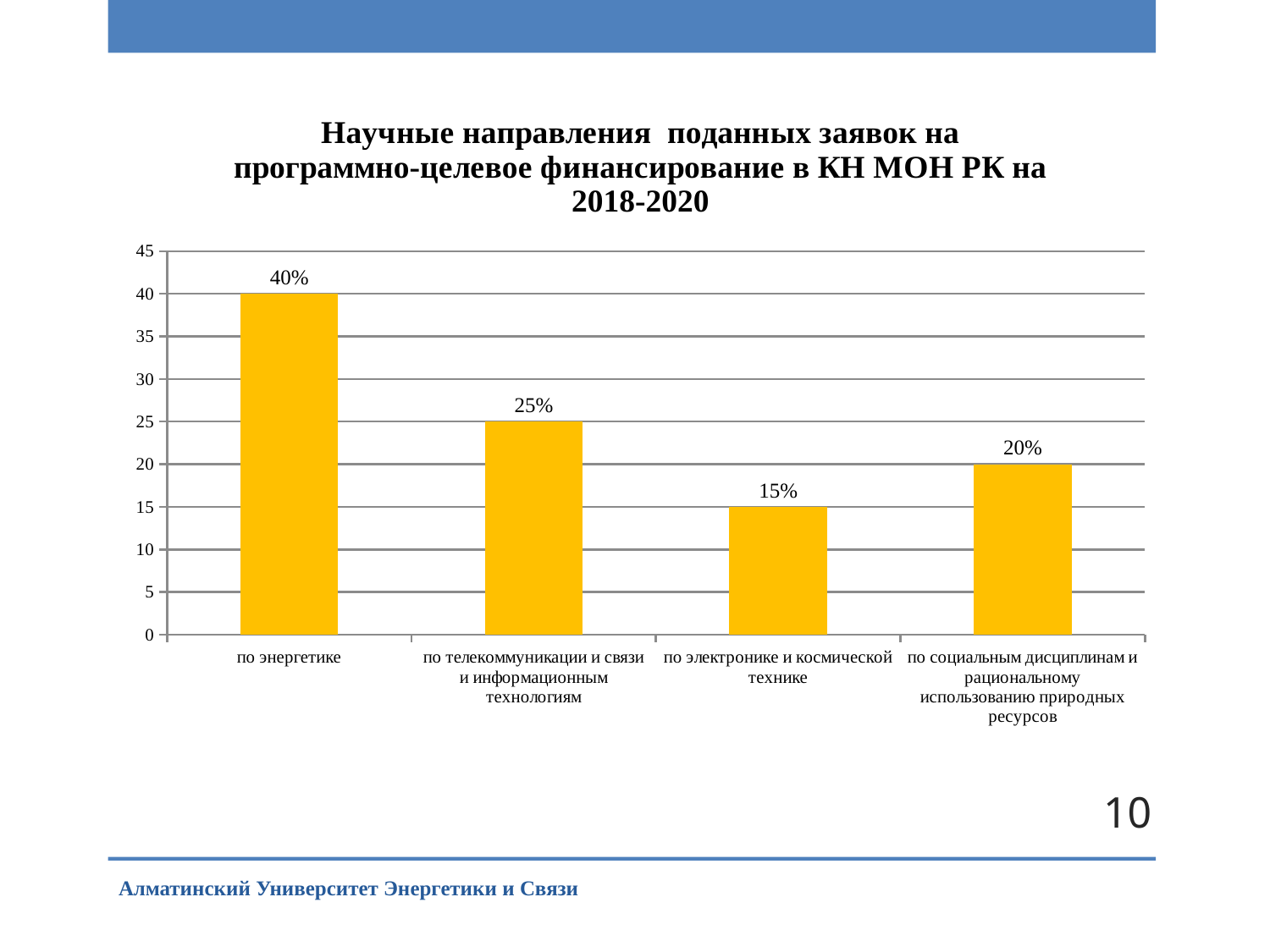
What is the value for "по электронике и космической технике"? 15% What is the difference between the values for "по энергетике" and "по телекоммуникации и связи и информационным технологиям"? 15% What is the value for "по энергетике"? 40% Is the value for "по телекоммуникации и связи и информационным технологиям" greater or less than 30? less What is the value for "по социальным дисциплинам и рациональному использованию природных ресурсов"? 20% Which category has the lowest value? по электронике и космической технике What kind of chart is shown on the slide? bar chart Which is larger: the value for "по социальным дисциплинам и рациональному использованию природных ресурсов" or the value for "по электронике и космической технике"? по социальным дисциплинам и рациональному использованию природных ресурсов What is the value for "по телекоммуникации и связи и информационным технологиям"? 25% Which category has the highest value? по энергетике How many categories are shown in the chart? 4 What colour are the bars in the chart? yellow